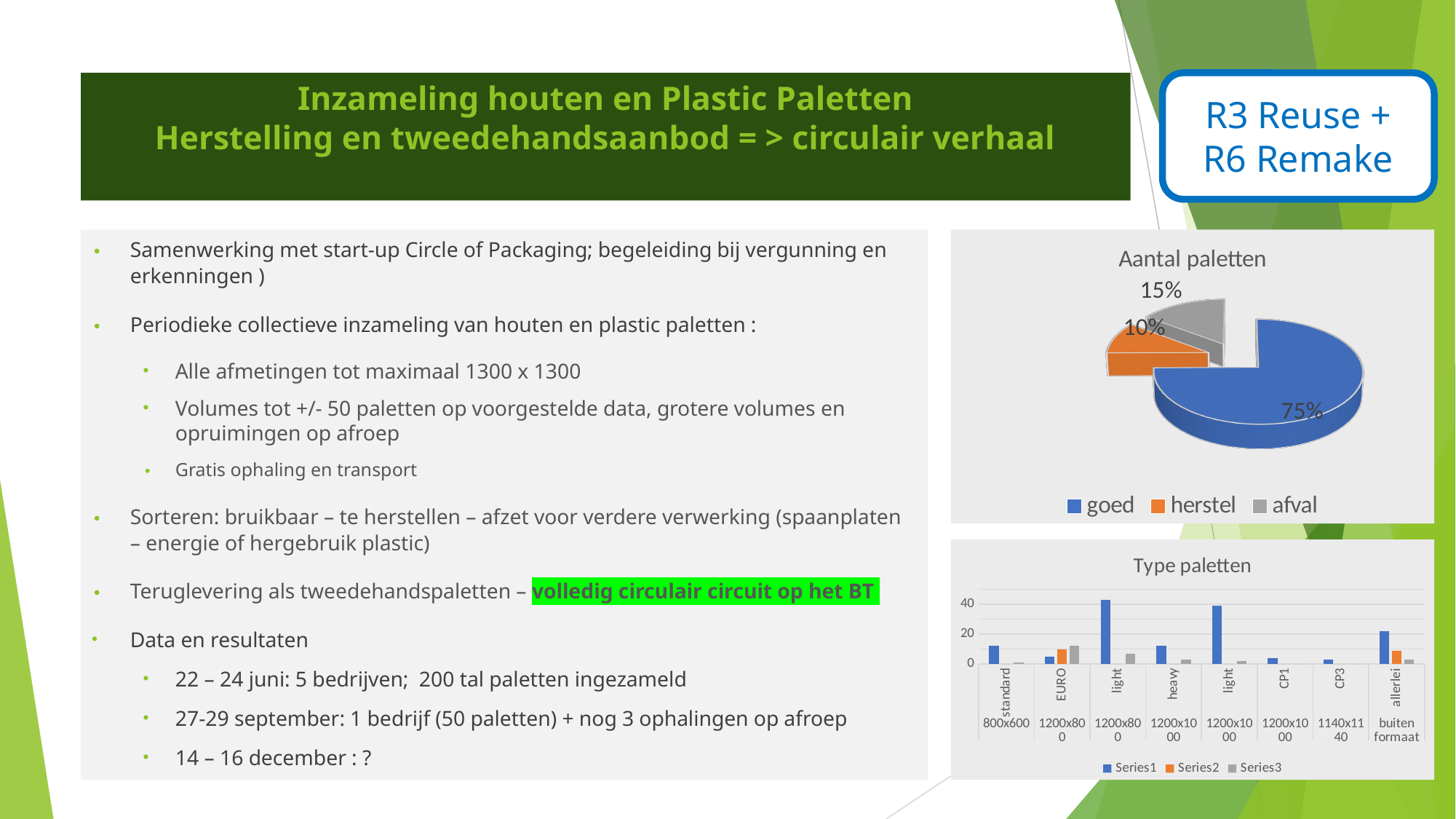
In the 'Aantal paletten' pie chart, what share is labelled for 'herstel'? 10% What kind of chart is the 'Type paletten' chart? bar chart In the 'Aantal paletten' pie chart, what is the difference in percentage points between 'afval' and 'herstel'? 5% In the 'Type paletten' chart, how many series does the legend list? 3 In the 'Aantal paletten' pie chart, which category has the smallest slice? herstel In the 'Type paletten' chart, is the Series1 value for 'standard 800x600' greater or less than 20? less In the 'Aantal paletten' pie chart, what share is labelled for 'afval'? 15% In the 'Type paletten' chart, how many categories are shown on the x axis? 8 In the 'Aantal paletten' chart, how many categories does the legend list? 3 In the 'Aantal paletten' pie chart, which category has the largest slice? goed In the 'Aantal paletten' pie chart, what share is labelled for 'goed'? 75% In the 'Type paletten' chart, which category has the highest Series1 bar? light 1200x800